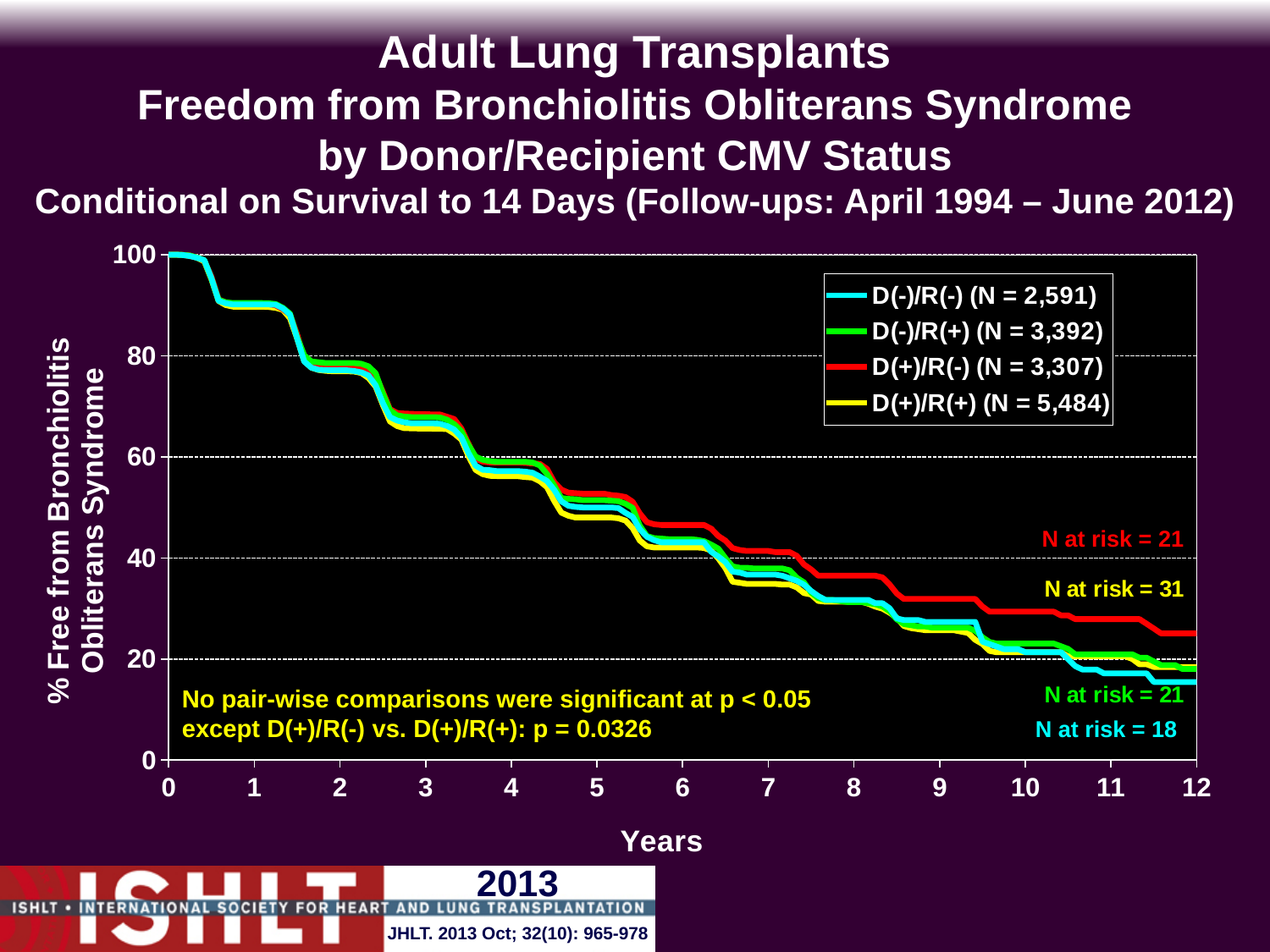
Do the curves rise or fall as years since transplant increase? fall What kind of chart is shown on the slide? line chart Which group has the smallest N in the legend? D(-)/R(-) How many series does the legend list? 4 Which curve is higher at 12 years, D(+)/R(-) or D(-)/R(-)? D(+)/R(-) What is the difference between the N for D(+)/R(+) and the N for D(-)/R(-)? 2,893 Is the value for the D(+)/R(-) curve at 12 years greater or less than 20? greater What is the N for the D(+)/R(+) group shown in the legend? 5,484 What is the N for the D(-)/R(-) group shown in the legend? 2,591 What is the p-value given for the D(+)/R(-) vs. D(+)/R(+) comparison? 0.0326 Which group has the largest N in the legend? D(+)/R(+) What is the N at risk shown for the D(+)/R(+) (yellow) curve at the end of follow-up? 31